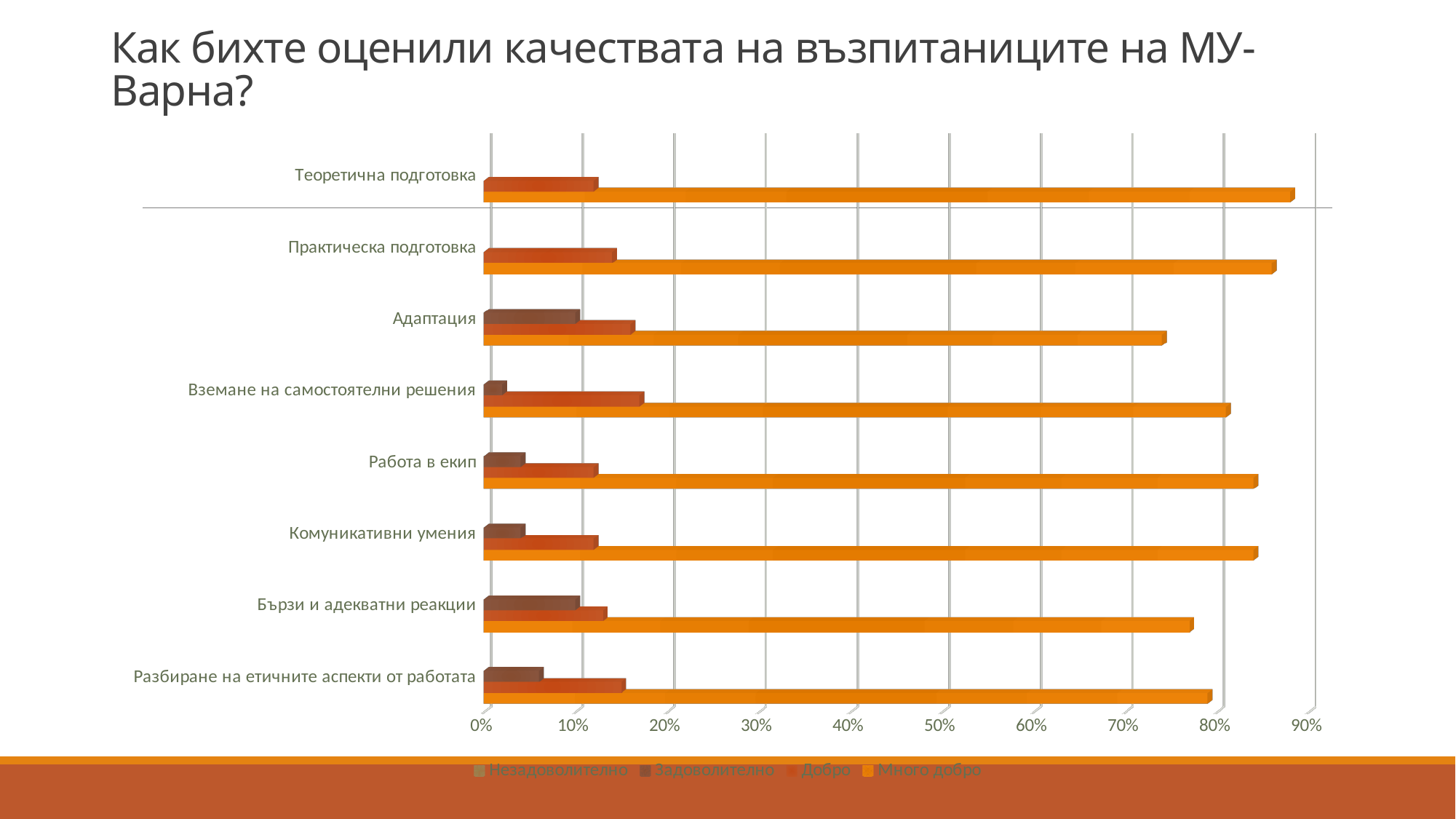
Is the value of Много добро for Теоретична подготовка greater or less than 80%? greater Is the value of Задоволително for Вземане на самостоятелни решения greater or less than 10%? less Which is larger: the Добро value for Вземане на самостоятелни решения or for Теоретична подготовка? Вземане на самостоятелни решения What kind of chart is shown on the slide? bar chart Which is larger: the Много добро value for Работа в екип or for Адаптация? Работа в екип How many categories are plotted on the chart? 8 Is the value of Много добро for Адаптация greater or less than 80%? less Which category has the lowest value for Много добро? Адаптация How many series does the legend list? 4 Which series is listed last in the legend? Много добро What is the title of the slide? Как бихте оценили качествата на възпитаниците на МУ-Варна?